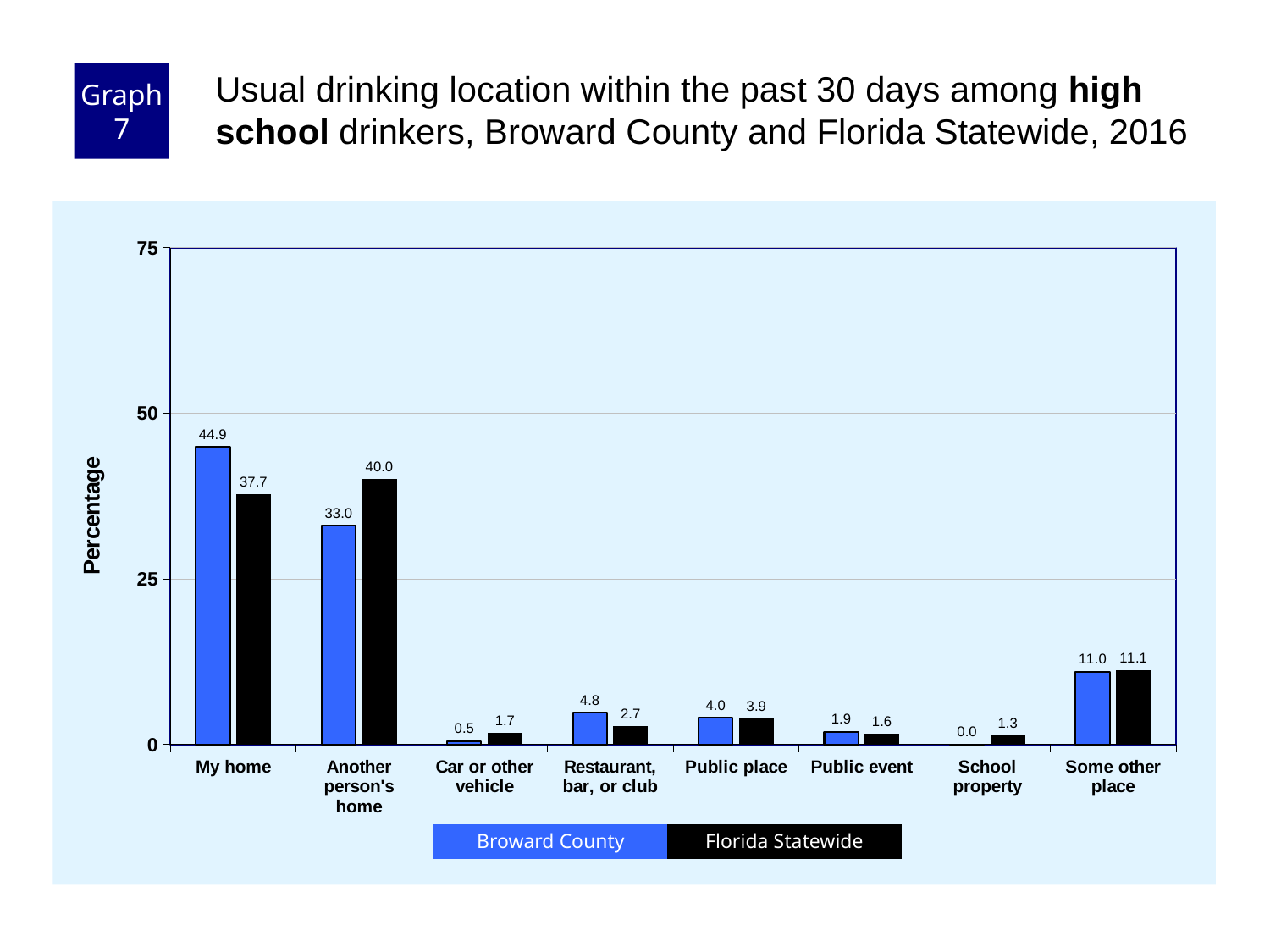
What is the Broward County value for School property? 0.0 How many location categories are shown on the x axis? 8 What is the difference between the Florida Statewide and Broward County values for Another person's home? 7.0 What is the Broward County value for My home? 44.9 Is the Broward County value for My home greater or less than 25? greater How many series does the legend list? 2 What is the difference between the Broward County and Florida Statewide values for My home? 7.2 What kind of chart is shown on the slide? bar chart Which category has the highest Broward County value? My home For Restaurant, bar, or club, which is larger: Broward County or Florida Statewide? Broward County What is the Florida Statewide value for Another person's home? 40.0 Which category has the lowest Florida Statewide value? School property